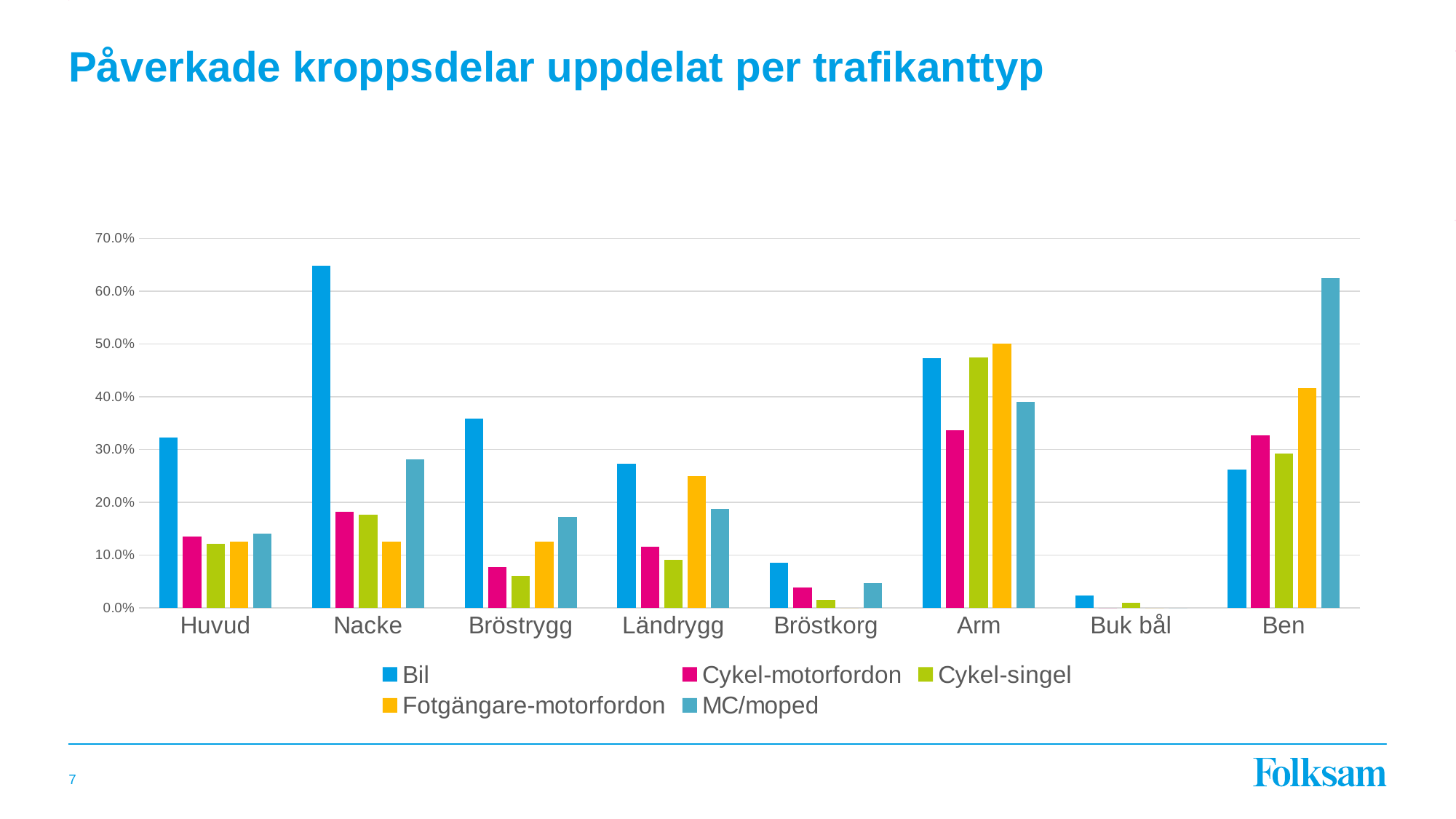
Is the Bil value for Nacke greater or less than 60.0%? greater Is the MC/moped value for Ben greater or less than 50.0%? greater For the Arm category, which is larger: the Fotgängare-motorfordon value or the Cykel-motorfordon value? Fotgängare-motorfordon For the Ländrygg category, which is larger: the Bil value or the MC/moped value? Bil What is the title of the chart on the slide? Påverkade kroppsdelar uppdelat per trafikanttyp How many body-part categories are shown on the x axis? 8 For the Ben category, which series has the highest value? MC/moped How many series does the legend list? 5 Which category has the lowest value for the Bil series? Buk bål What kind of chart is shown on the slide? Bar chart Is the Cykel-motorfordon value for Nacke greater or less than 20.0%? less Which category has the highest value for the Bil series? Nacke